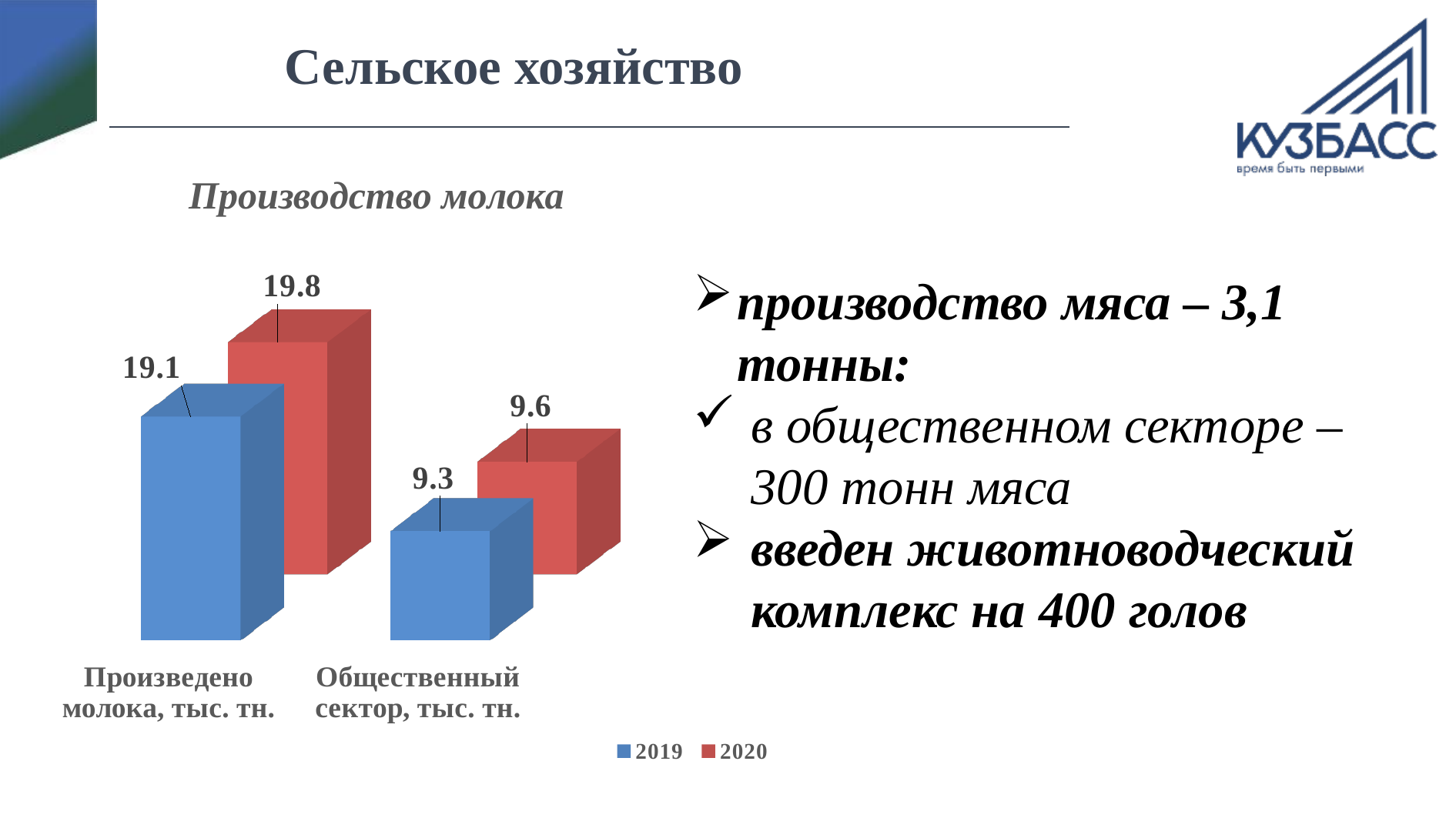
What is the 2020 value for "Общественный сектор, тыс. тн."? 9.6 Which category has the highest 2020 value? Произведено молока, тыс. тн. What is the 2020 value for "Произведено молока, тыс. тн."? 19.8 What is the difference between the 2020 and 2019 values for "Общественный сектор, тыс. тн."? 0.3 What type of chart is shown on the slide? Bar chart How many categories are shown on the x axis of the chart? 2 What is the difference between the 2020 and 2019 values for "Произведено молока, тыс. тн."? 0.7 How many series does the chart legend list? 2 What is the 2019 value for "Произведено молока, тыс. тн."? 19.1 What is the 2019 value for "Общественный сектор, тыс. тн."? 9.3 For "Общественный сектор, тыс. тн.", which year has the larger value, 2019 or 2020? 2020 Which category has the lowest 2019 value? Общественный сектор, тыс. тн.